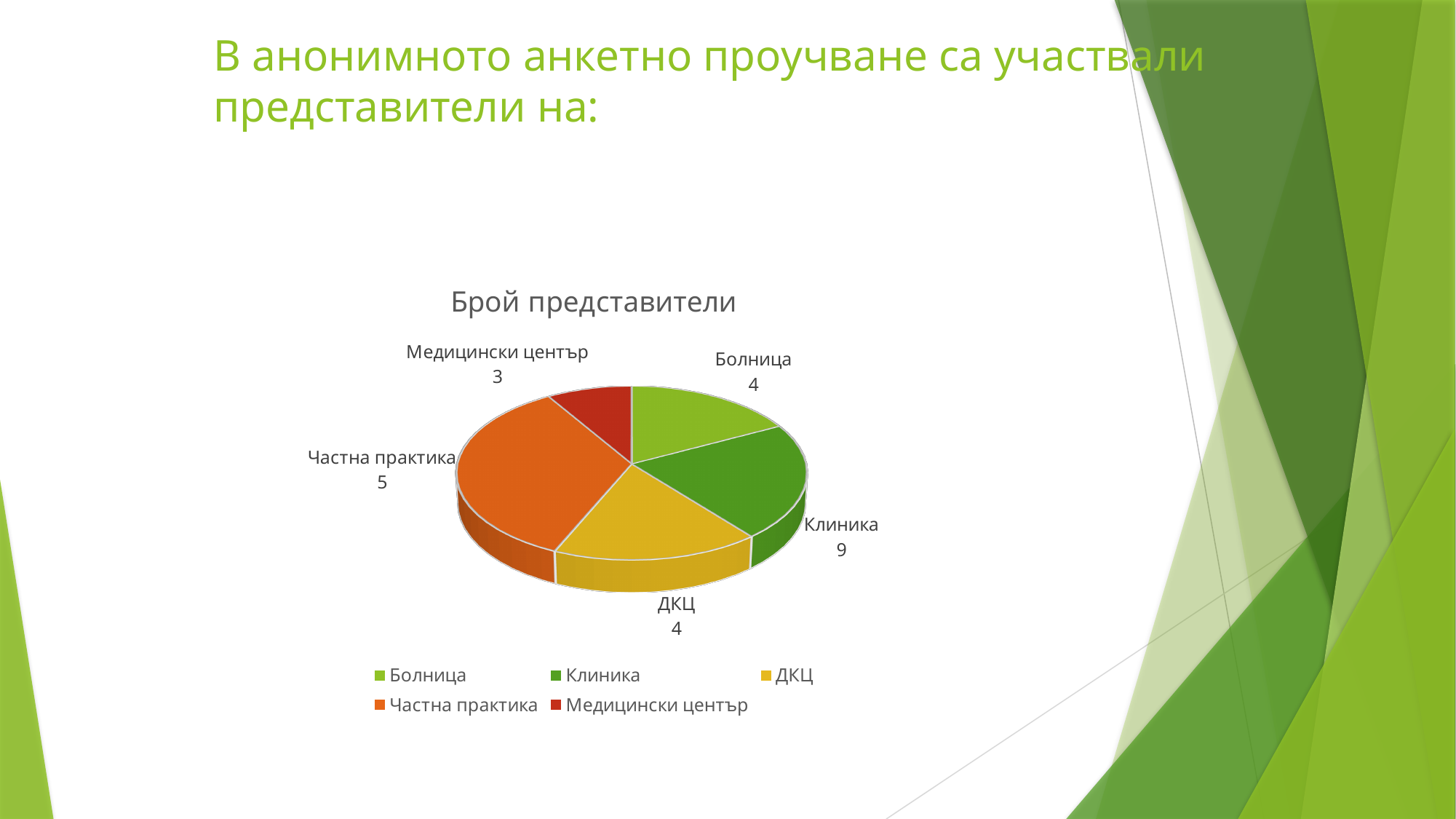
What is the difference between the values for Клиника and Частна практика? 4 What type of chart is shown on the slide? pie chart How many categories does the pie chart have? 5 Which category has the largest slice of the pie? Частна практика How many representatives are from Клиника? 9 What is the total of all values in the pie chart? 25 Which is larger, the value for Частна практика or the value for ДКЦ? Частна практика Which category has the smallest slice of the pie? Медицински център What is the value for Частна практика? 5 What is the value for Медицински център? 3 What is the title of the chart? Брой представители